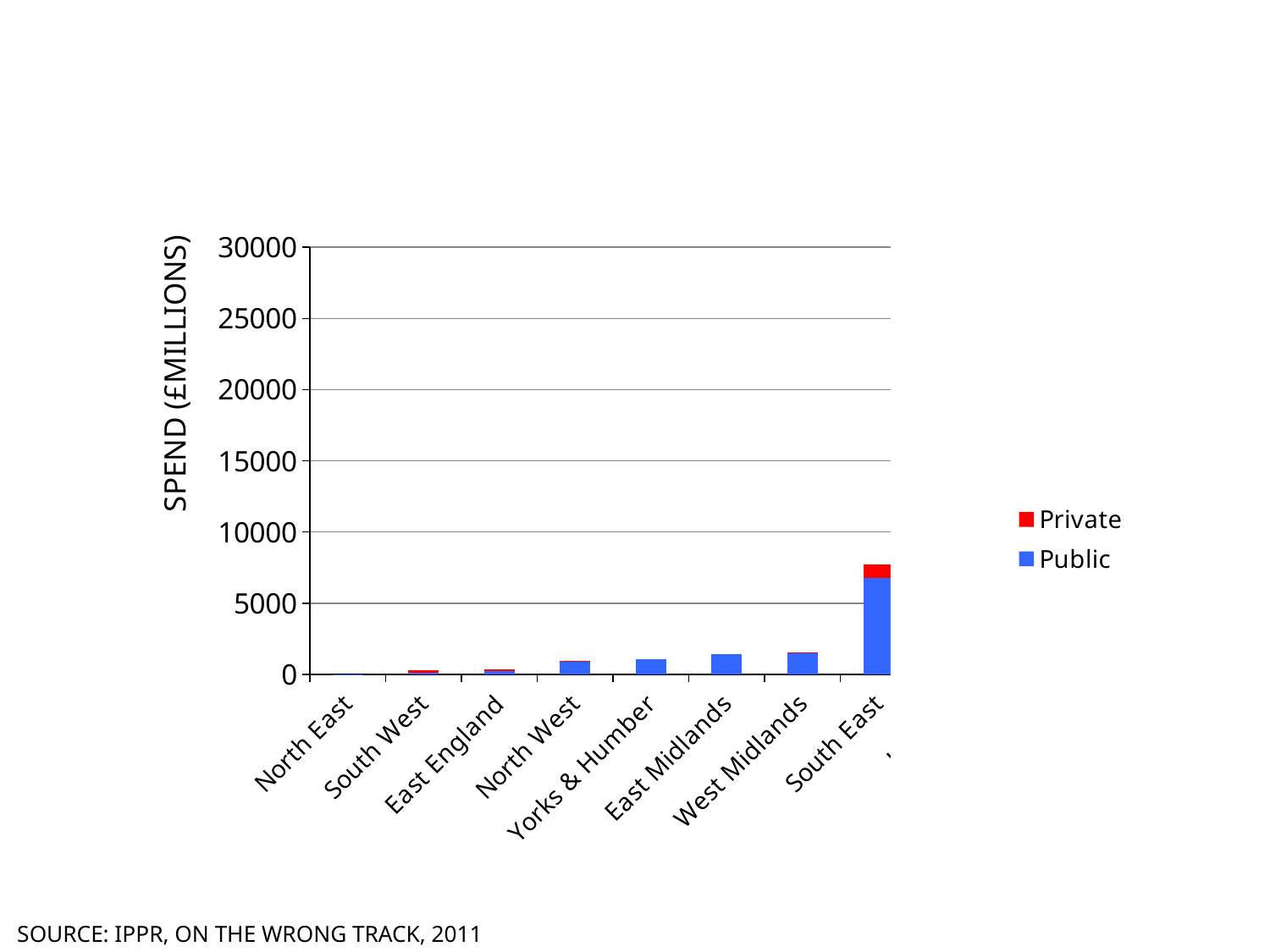
How many series does the legend list? 2 Do the total spend values generally rise or fall moving from left to right along the x axis? Rise Which region has the lowest total spend? North East Which has the larger total spend, South East or West Midlands? South East Which colour represents the Private series in the legend? Red What kind of chart is shown on the slide? Stacked bar chart Is the total spend for South East greater or less than 10000? less Which has the larger total spend, East Midlands or North West? East Midlands What is the label on the vertical axis? SPEND (£MILLIONS) Is the total spend for West Midlands greater or less than 5000? less Is the total spend for South East greater or less than 5000? greater